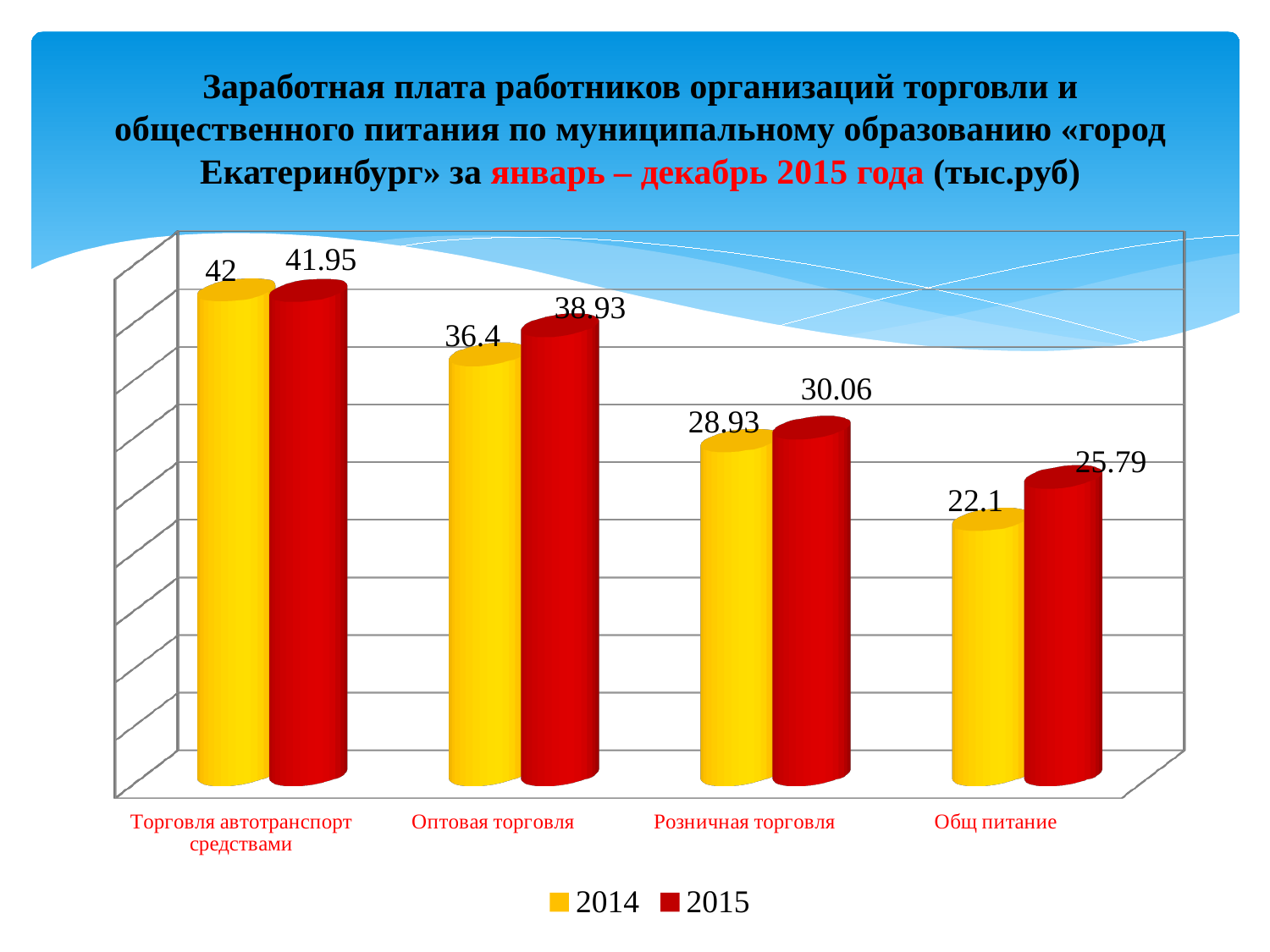
What is the 2014 value for Торговля автотранспорт средствами? 42 What is the difference between the 2015 and 2014 values for Общ питание? 3.69 What is the 2015 value for Общ питание? 25.79 Which category has the lowest 2014 value? Общ питание Which category has the highest 2015 value? Торговля автотранспорт средствами Which is larger for Розничная торговля, the 2014 value or the 2015 value? 2015 How many series does the legend list? 2 What is the 2015 value for Розничная торговля? 30.06 What is the 2014 value for Оптовая торговля? 36.4 How many categories are shown on the x axis? 4 What is the difference between the 2015 and 2014 values for Оптовая торговля? 2.53 What kind of chart is shown on the slide? bar chart